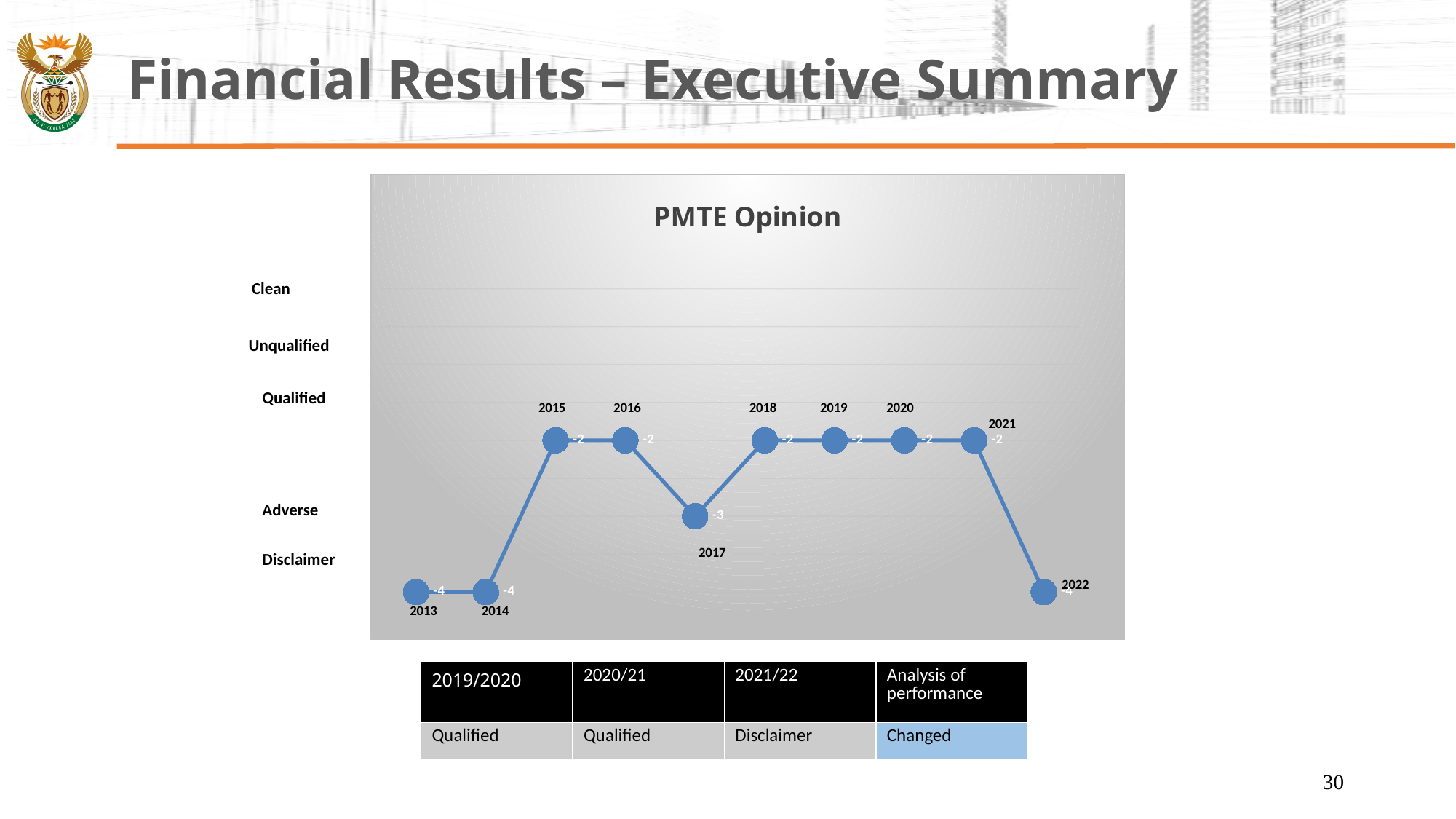
What is the difference between the values for 2021 and 2022 on the PMTE Opinion chart? 2 What is the title of the chart? PMTE Opinion What kind of chart is the PMTE Opinion chart? line chart What is the data label value for 2013 on the PMTE Opinion chart? -4 What is the data label value for 2022 on the PMTE Opinion chart? -4 What is the data label value for 2021 on the PMTE Opinion chart? -2 What is the data label value for 2017 on the PMTE Opinion chart? -3 What is the first year shown on the PMTE Opinion chart? 2013 Which of 2016 or 2017 has the higher value on the PMTE Opinion chart? 2016 Does the value on the PMTE Opinion chart rise or fall from 2021 to 2022? fall Does the value on the PMTE Opinion chart rise or fall from 2014 to 2015? rise How many data points are plotted on the PMTE Opinion chart? 10